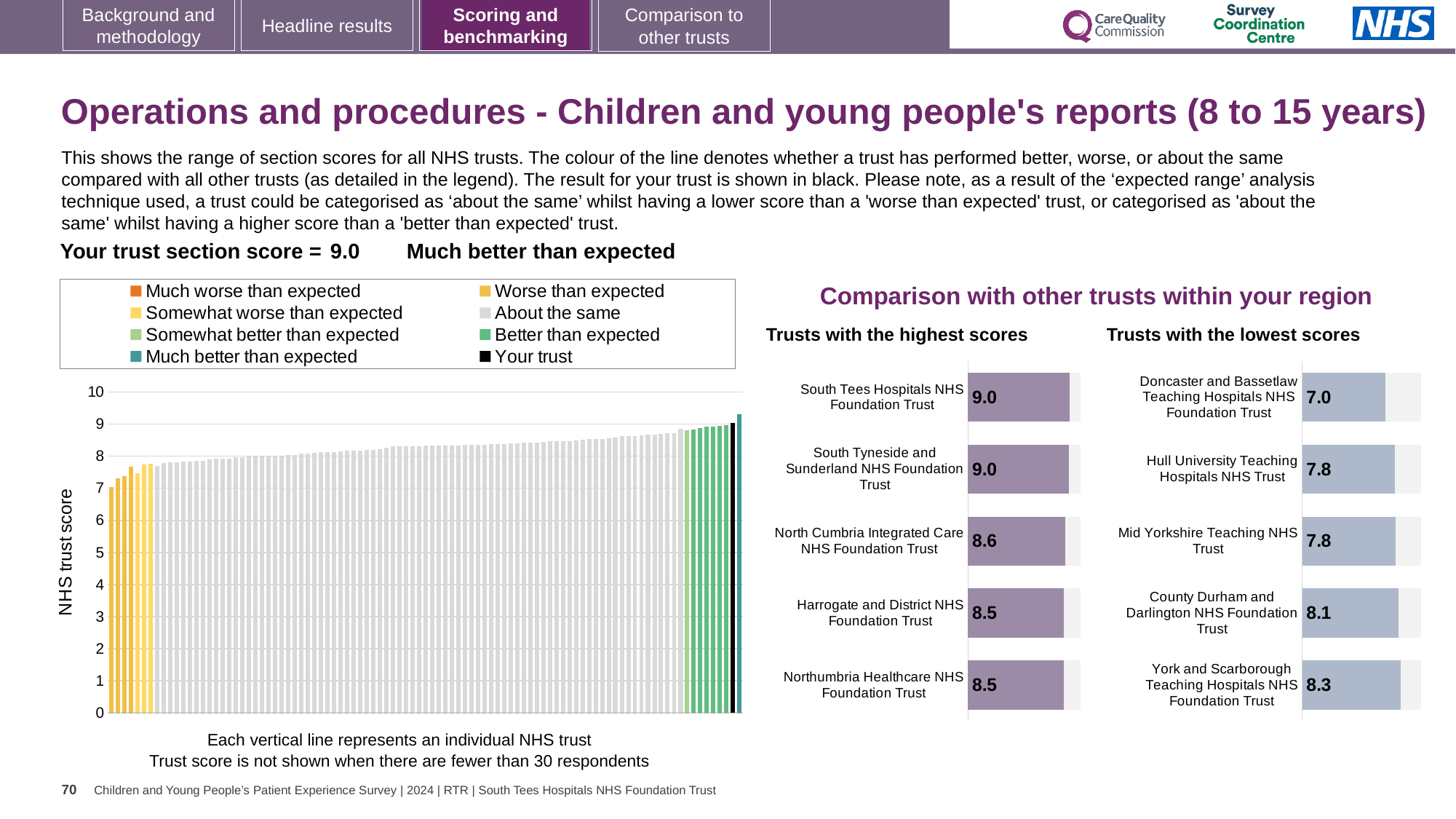
In the 'Trusts with the lowest scores' chart, what is the score for Hull University Teaching Hospitals NHS Trust? 7.8 In the 'Trusts with the lowest scores' chart, which trust has the highest score? York and Scarborough Teaching Hospitals NHS Foundation Trust In the large chart on the left, is the value of the lowest bar greater or less than 6? greater How many trusts are listed in the 'Trusts with the highest scores' chart? 5 What type of chart is the large chart on the left of the slide? Bar chart In the 'Trusts with the highest scores' chart, what is the difference between the scores of North Cumbria Integrated Care NHS Foundation Trust and Harrogate and District NHS Foundation Trust? 0.1 How many entries does the legend of the large chart on the left list? 8 In the large chart on the left, is the value of the highest bar greater or less than 9? greater In the 'Trusts with the lowest scores' chart, which has the larger score: County Durham and Darlington NHS Foundation Trust or Mid Yorkshire Teaching NHS Trust? County Durham and Darlington NHS Foundation Trust In the 'Trusts with the lowest scores' chart, which trust has the lowest score? Doncaster and Bassetlaw Teaching Hospitals NHS Foundation Trust In the 'Trusts with the highest scores' chart, what is the score for North Cumbria Integrated Care NHS Foundation Trust? 8.6 In the 'Trusts with the lowest scores' chart, what is the difference between the scores of York and Scarborough Teaching Hospitals NHS Foundation Trust and Doncaster and Bassetlaw Teaching Hospitals NHS Foundation Trust? 1.3